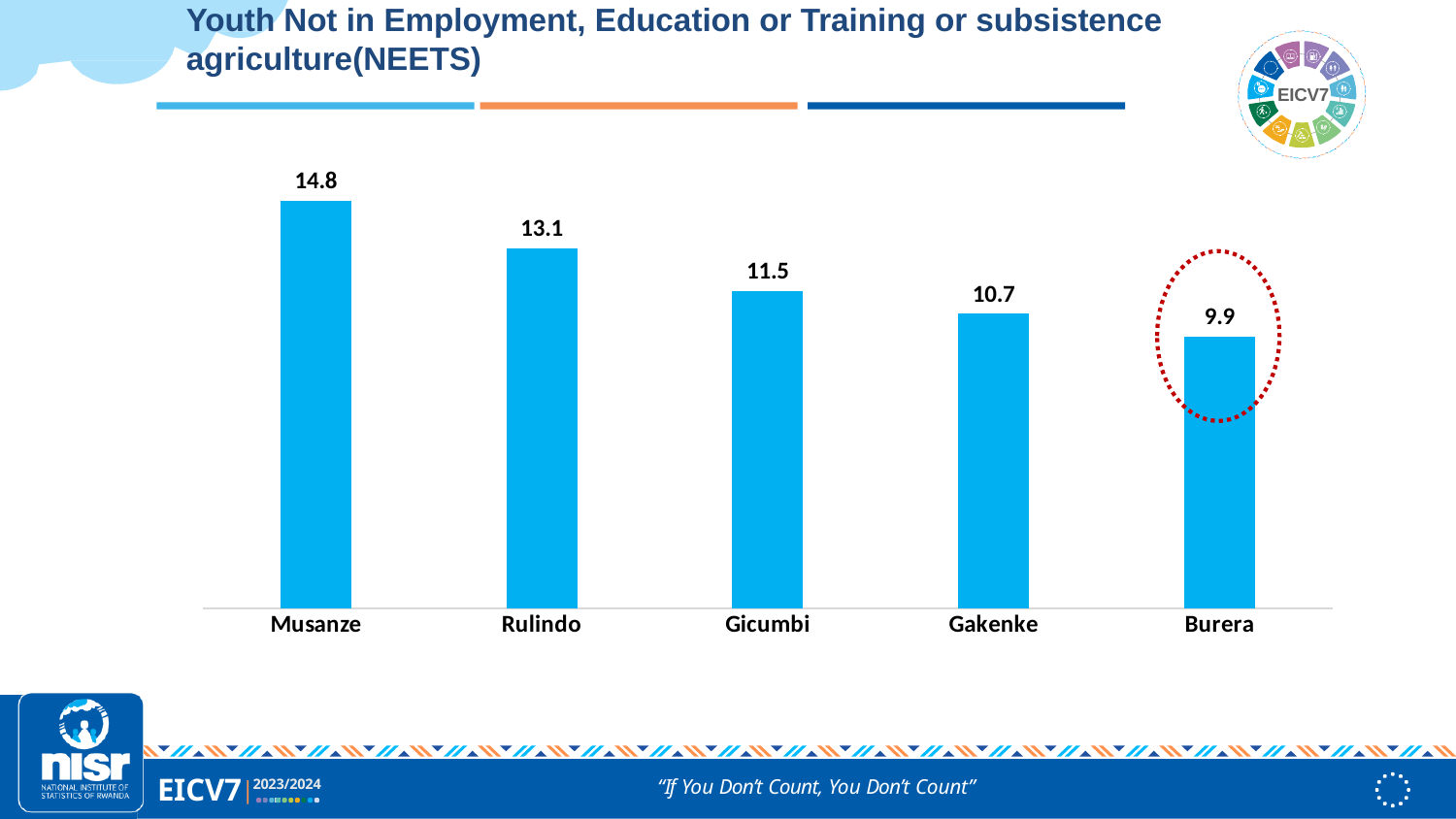
What is the value for Gakenke? 10.7 Do the values rise or fall from left to right across the districts? Fall What is the difference between the values for Musanze and Burera? 4.9 What is the value for Gicumbi? 11.5 What is the value for Musanze? 14.8 What is the value for Rulindo? 13.1 Which is larger, the value for Rulindo or the value for Gakenke? Rulindo How many districts are shown in the chart? 5 Which district has the highest value? Musanze Which district has the lowest value? Burera What is the value for Burera? 9.9 What kind of chart is shown on the slide? Bar chart